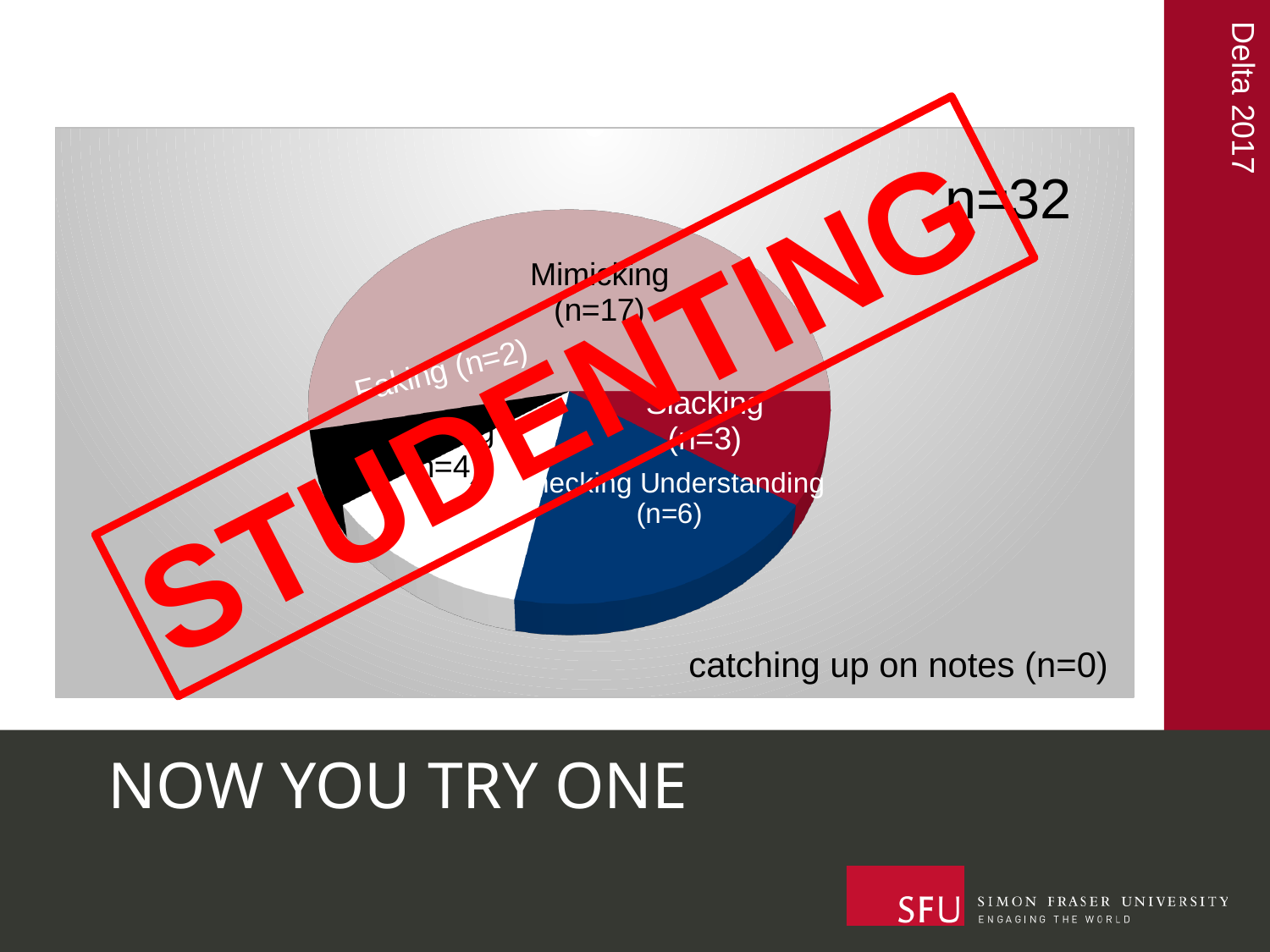
Which category has the smallest value? catching up on notes What word is stamped in red across the chart? STUDENTING What is the difference between the values for Mimicking and Checking Understanding? 11 What is the value (n) for Checking Understanding? 6 What is the value (n) for catching up on notes? 0 Which is larger, the value for Checking Understanding or the value for Slacking? Checking Understanding What is the value (n) for Mimicking? 17 What kind of chart is shown on the slide? pie chart What is the value (n) for Slacking? 3 Which category has the largest slice of the pie? Mimicking How many categories are labelled on the pie chart? 6 What is the total n shown for the pie chart? 32